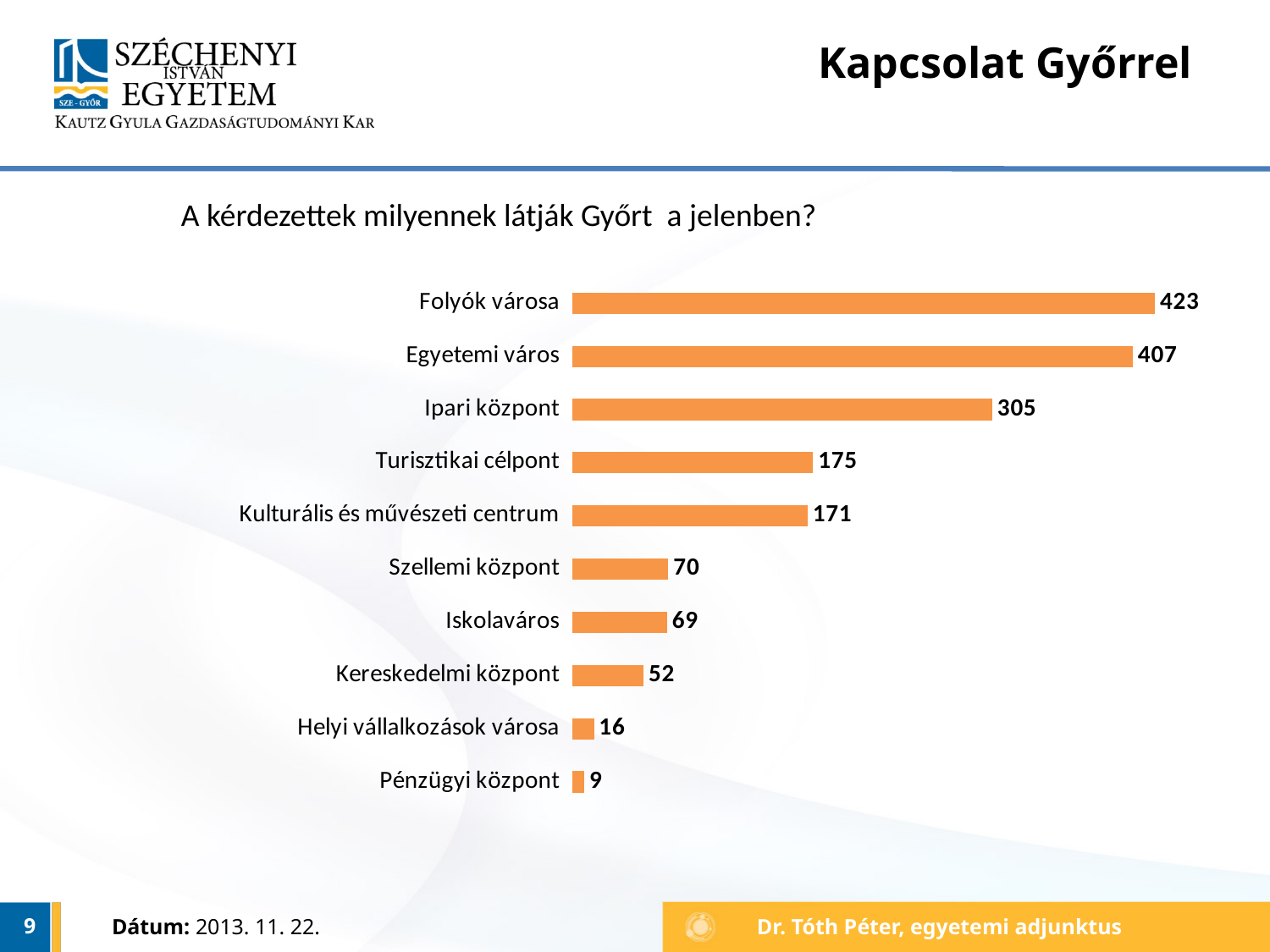
Which category has the lowest value? Pénzügyi központ What is the value for Kereskedelmi központ? 52 Which category has the highest value? Folyók városa What is the value for Ipari központ? 305 Which is larger, the value for Szellemi központ or the value for Kereskedelmi központ? Szellemi központ What is the difference between the values for Folyók városa and Egyetemi város? 16 What question is written above the chart? A kérdezettek milyennek látják Győrt a jelenben? How many categories are shown in the chart? 10 What is the value for Folyók városa? 423 What kind of chart is shown on the slide? Bar chart What is the difference between the values for Ipari központ and Turisztikai célpont? 130 Which is larger, the value for Turisztikai célpont or the value for Kulturális és művészeti centrum? Turisztikai célpont